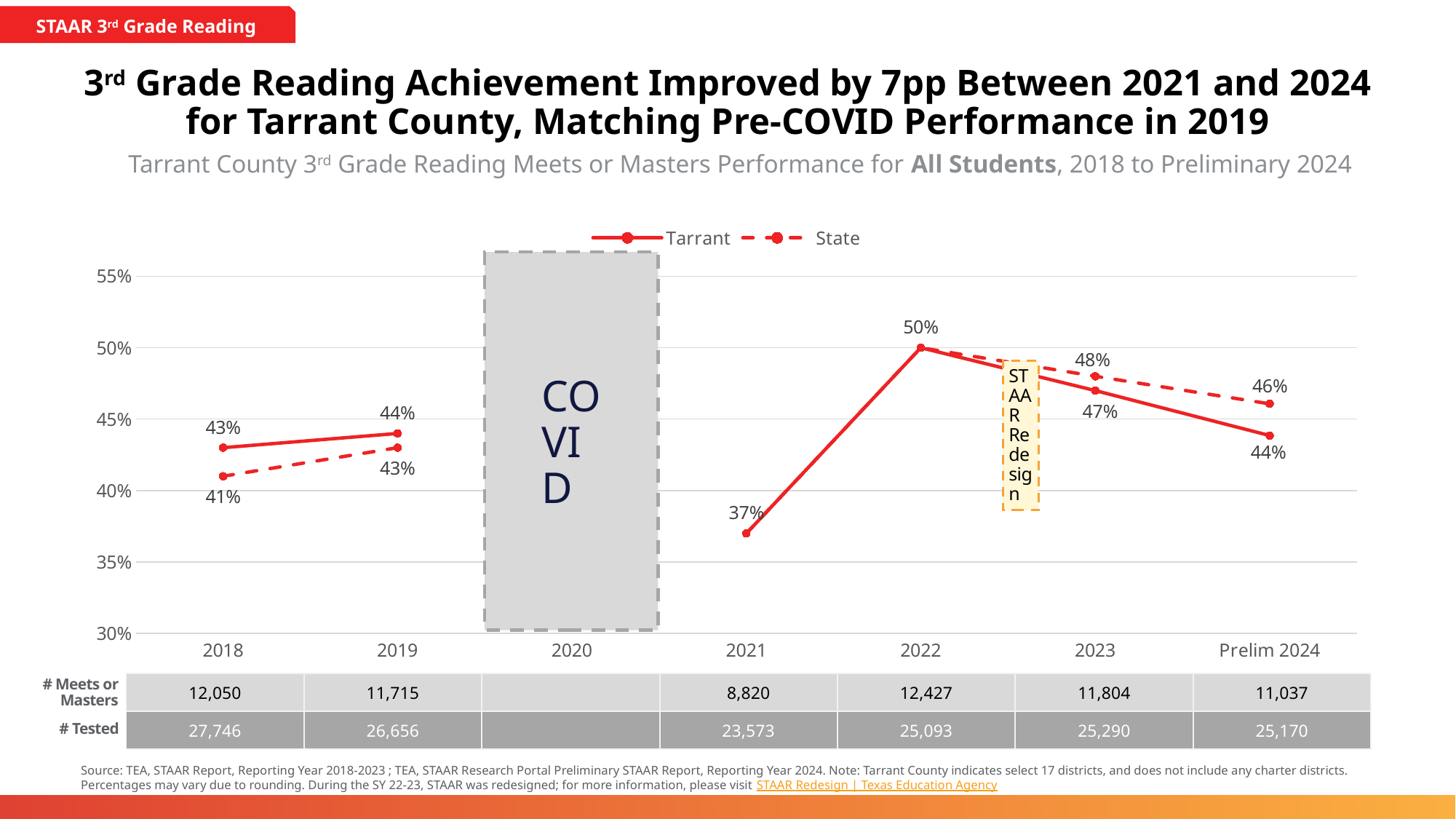
What kind of chart is shown on the slide? Line chart What is the # Tested value shown for 2021 in the table below the chart? 23,573 In which year does the Tarrant line reach its lowest value? 2021 In 2023, which is higher, the Tarrant value or the State value? State What is the # Meets or Masters value shown for 2022 in the table below the chart? 12,427 What is the State value for Prelim 2024? 46% How many series does the legend list? 2 In which year does the Tarrant line reach its highest value? 2022 What is the Tarrant value for 2021? 37% What is the Tarrant value for 2018? 43% What is the State value for 2019? 43% By how many percentage points did the Tarrant value rise from 2021 to 2022? 13 percentage points